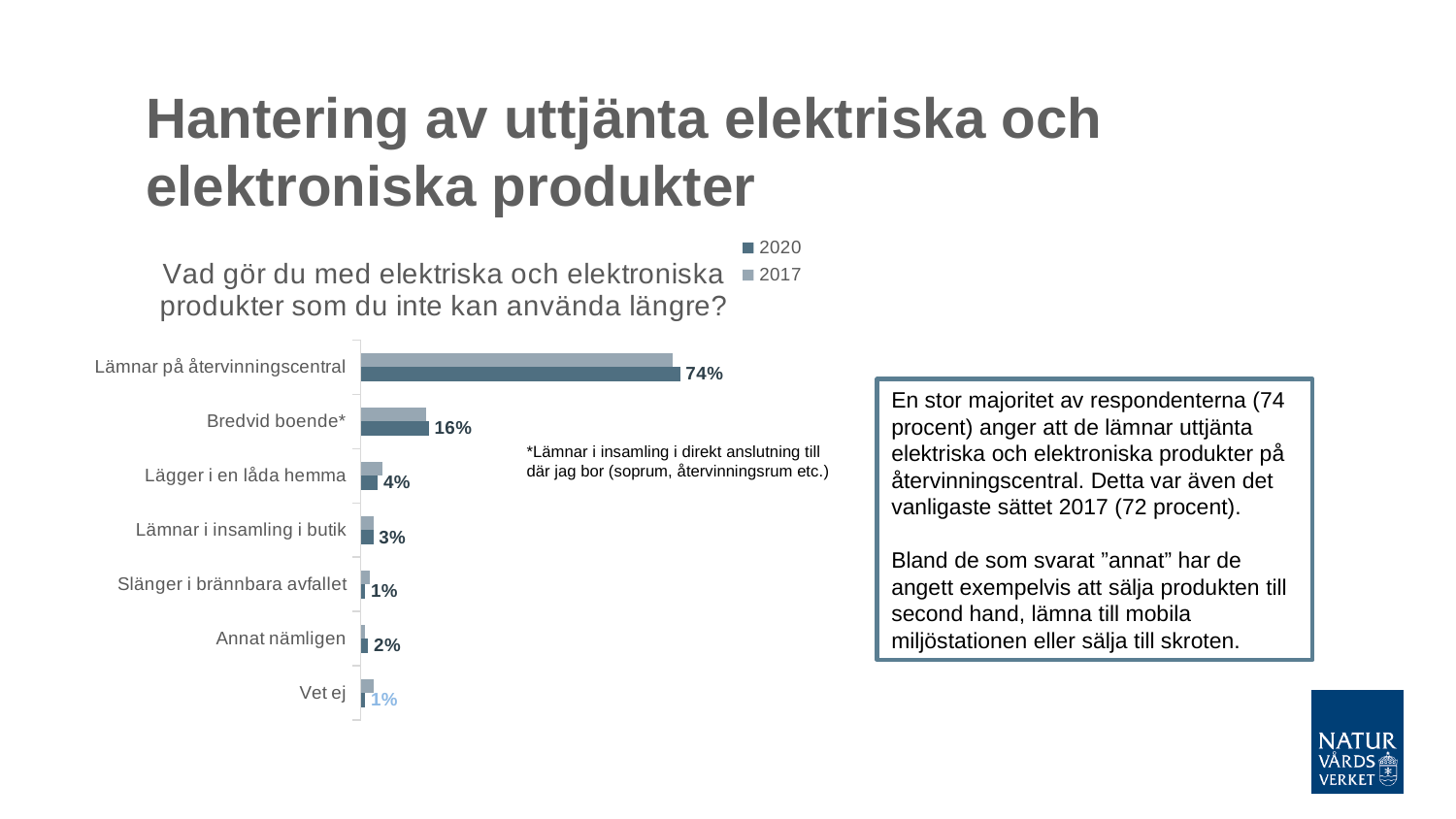
What is the 2020 value for "Lägger i en låda hemma"? 4% Which years are listed in the chart legend? 2020 and 2017 What is the 2020 value for "Lämnar på återvinningscentral"? 74% What is the 2020 value for "Bredvid boende*"? 16% What is the 2020 value for "Lämnar i insamling i butik"? 3% What kind of chart is shown on the slide? Bar chart Which category has the highest 2020 value? Lämnar på återvinningscentral How many categories are shown in the chart? 7 Which has the larger 2020 value, "Bredvid boende*" or "Lägger i en låda hemma"? Bredvid boende* What is the 2020 value for "Annat nämligen"? 2% What is the difference between the 2020 values for "Lämnar på återvinningscentral" and "Bredvid boende*"? 58 percentage points How many series does the legend list? 2